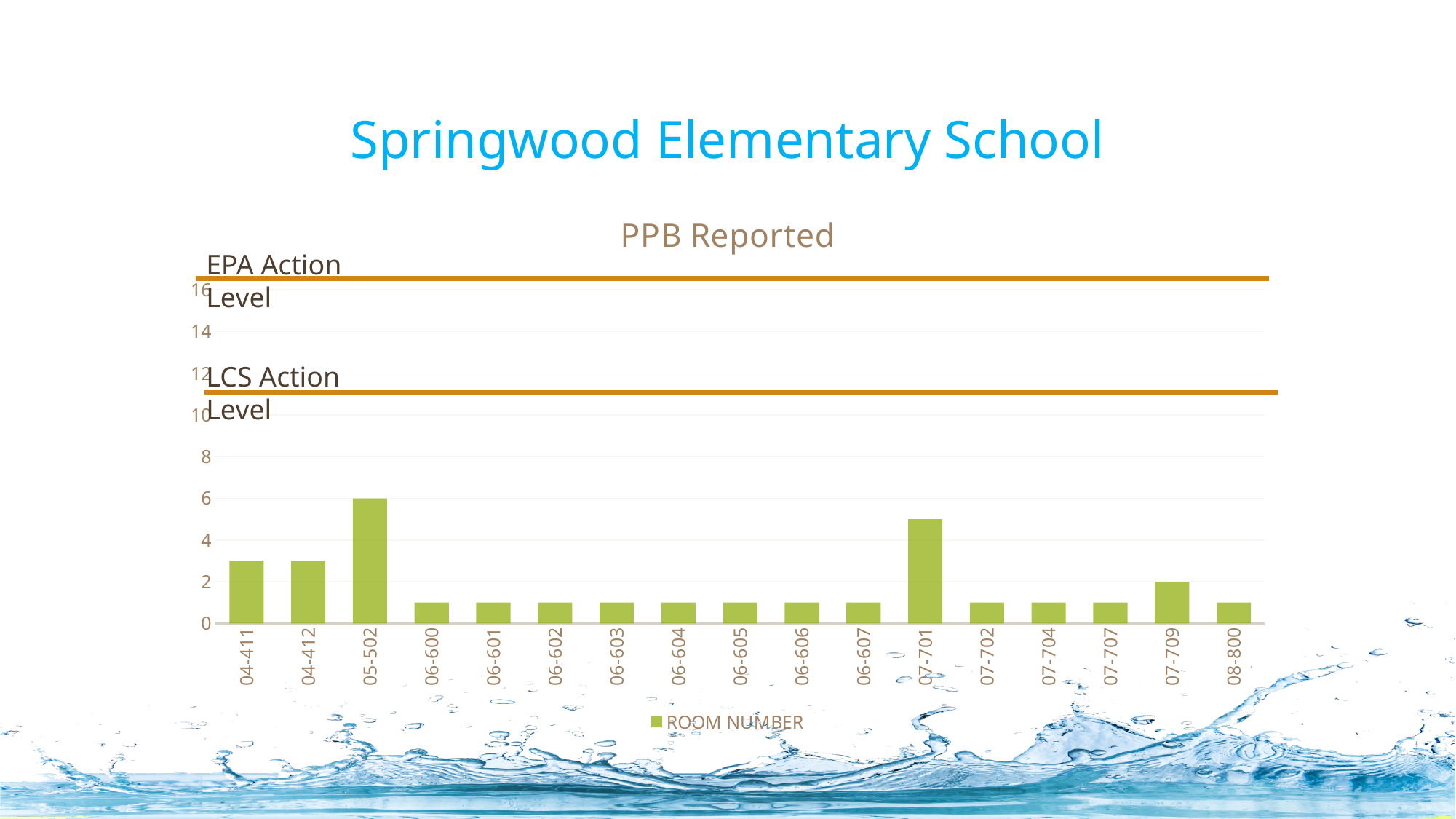
Is the value for room 07-701 greater or less than 4? greater Which has a higher PPB reported value, room 05-502 or room 07-701? 05-502 What is the name of the series shown in the legend? ROOM NUMBER What is the PPB reported value for room 07-709? 2 Is the value for room 04-411 greater or less than 2? greater How many room numbers are plotted along the x axis? 17 Is the value for room 06-600 greater or less than 2? less How many series does the legend list? 1 What is the PPB reported value for room 05-502? 6 What is the title of the chart? PPB Reported Which room number has the highest PPB reported? 05-502 What type of chart is shown on the slide? bar chart